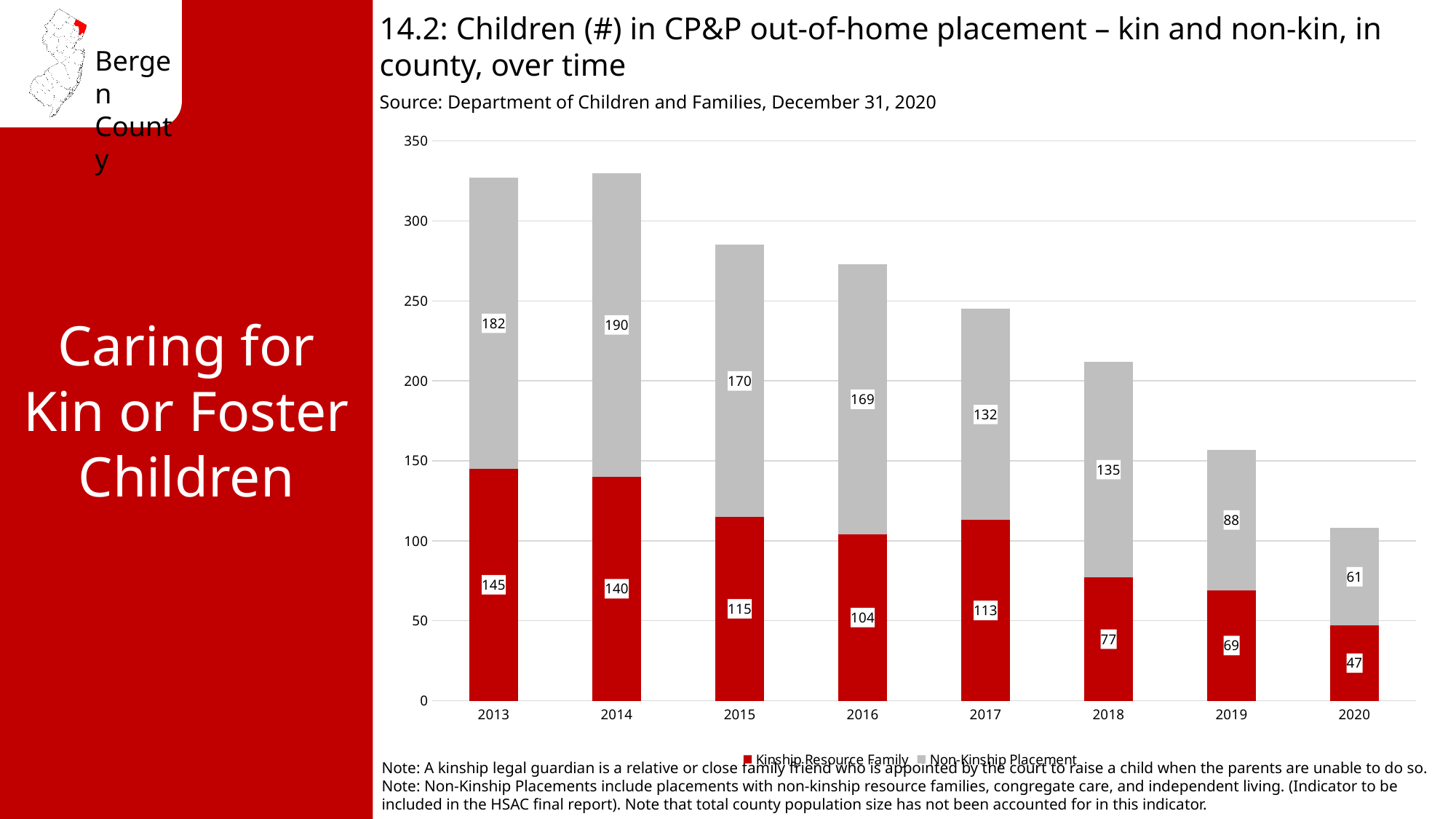
Which is larger in 2018: the Kinship Resource Family value or the Non-Kinship Placement value? Non-Kinship Placement Do the Kinship Resource Family values generally rise or fall from 2013 to 2020? fall What is the difference between the Non-Kinship Placement value and the Kinship Resource Family value in 2017? 19 What is the Non-Kinship Placement value for 2019? 88 How many years are shown on the x axis of the chart? 8 Is the total stacked bar for 2016 greater or less than 250? greater How many series does the chart's legend list? 2 Which year has the highest Non-Kinship Placement value? 2014 What is the total number of children in out-of-home placement in 2020 (both series combined)? 108 What type of chart is shown on the slide? Stacked bar chart Which year has the lowest Kinship Resource Family value? 2020 What is the Kinship Resource Family value for 2013? 145